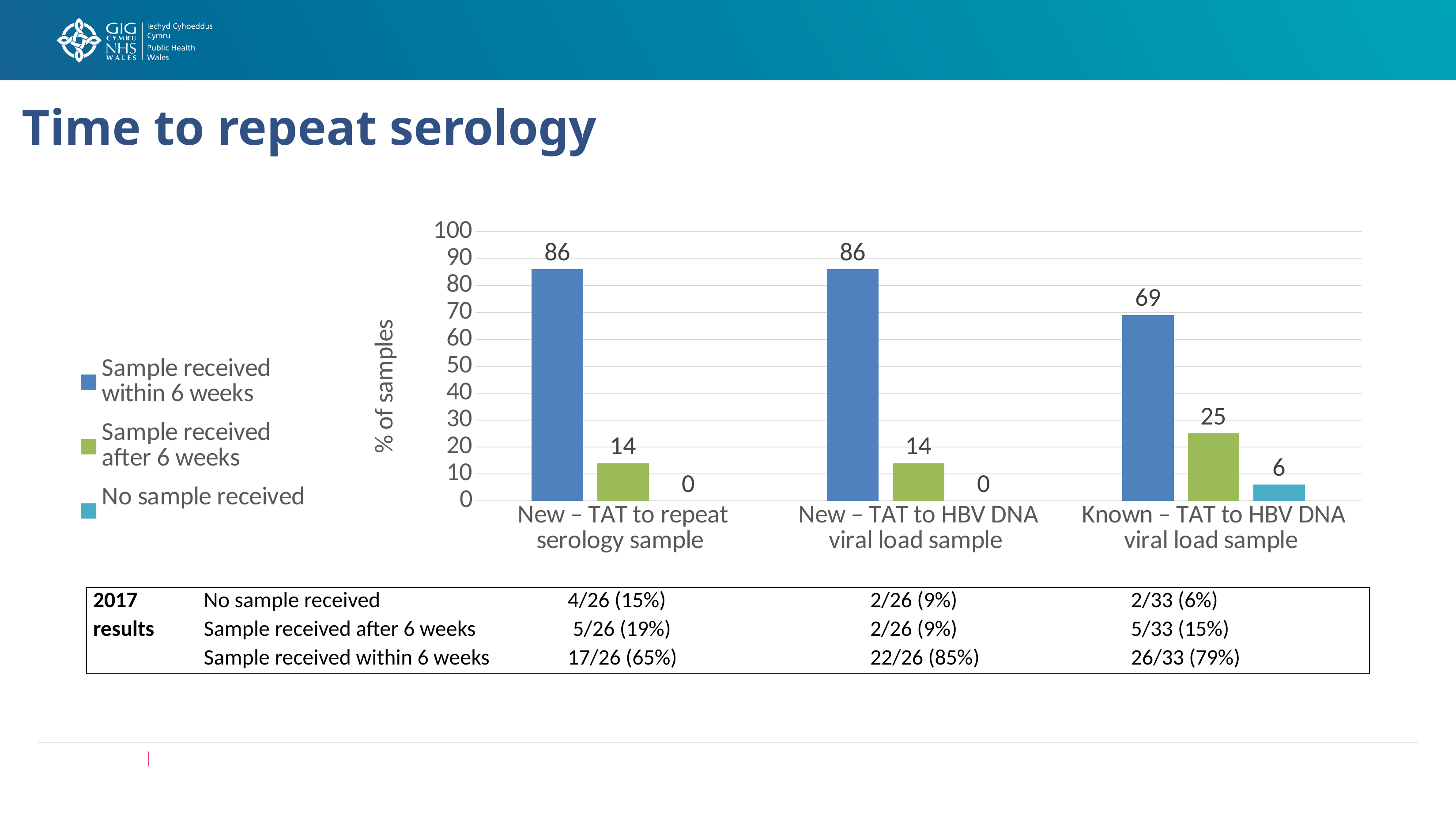
What kind of chart is shown on the slide? Bar chart What is the label of the y axis of the chart? % of samples Which category has the lowest value for 'Sample received within 6 weeks'? Known – TAT to HBV DNA viral load sample How many categories are shown on the x axis of the chart? 3 How many series does the legend list? 3 What is the value for 'No sample received' in the 'Known – TAT to HBV DNA viral load sample' category? 6 What is the value for 'No sample received' in the 'New – TAT to HBV DNA viral load sample' category? 0 Which is larger in the 'New – TAT to repeat serology sample' category: 'Sample received within 6 weeks' or 'Sample received after 6 weeks'? Sample received within 6 weeks What is the difference between 'Sample received within 6 weeks' and 'Sample received after 6 weeks' in the 'Known – TAT to HBV DNA viral load sample' category? 44 What is the value for 'Sample received within 6 weeks' in the 'New – TAT to repeat serology sample' category? 86 Which category has the highest value for 'Sample received after 6 weeks'? Known – TAT to HBV DNA viral load sample What is the value for 'Sample received after 6 weeks' in the 'Known – TAT to HBV DNA viral load sample' category? 25